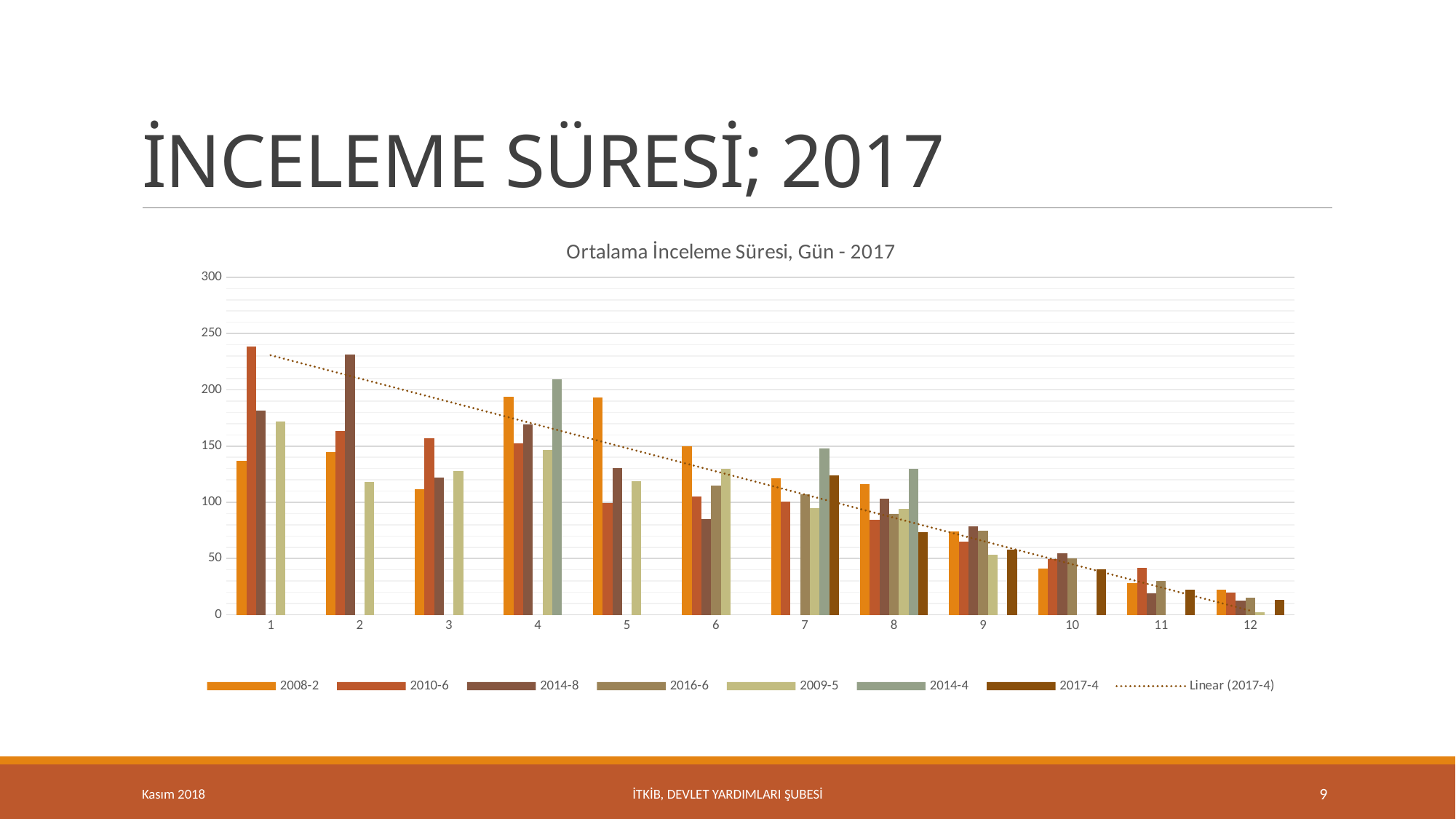
How many entries does the chart legend list? 8 Which legend entry is drawn as a dotted trend line? Linear (2017-4) What kind of chart is shown on the slide? bar chart At category 3, which is larger: the value for 2014-8 or the value for 2008-2? 2014-8 Do the values for the 2008-2 series generally rise or fall from category 1 to category 12? fall Is the value for 2008-2 at category 12 greater or less than 50? less What is the title of the chart? Ortalama İnceleme Süresi, Gün - 2017 Which series has the highest value at category 1? 2010-6 How many categories are shown on the x axis? 12 Is the value for 2010-6 at category 1 greater or less than 200? greater Is the value for 2017-4 at category 10 greater or less than 50? less